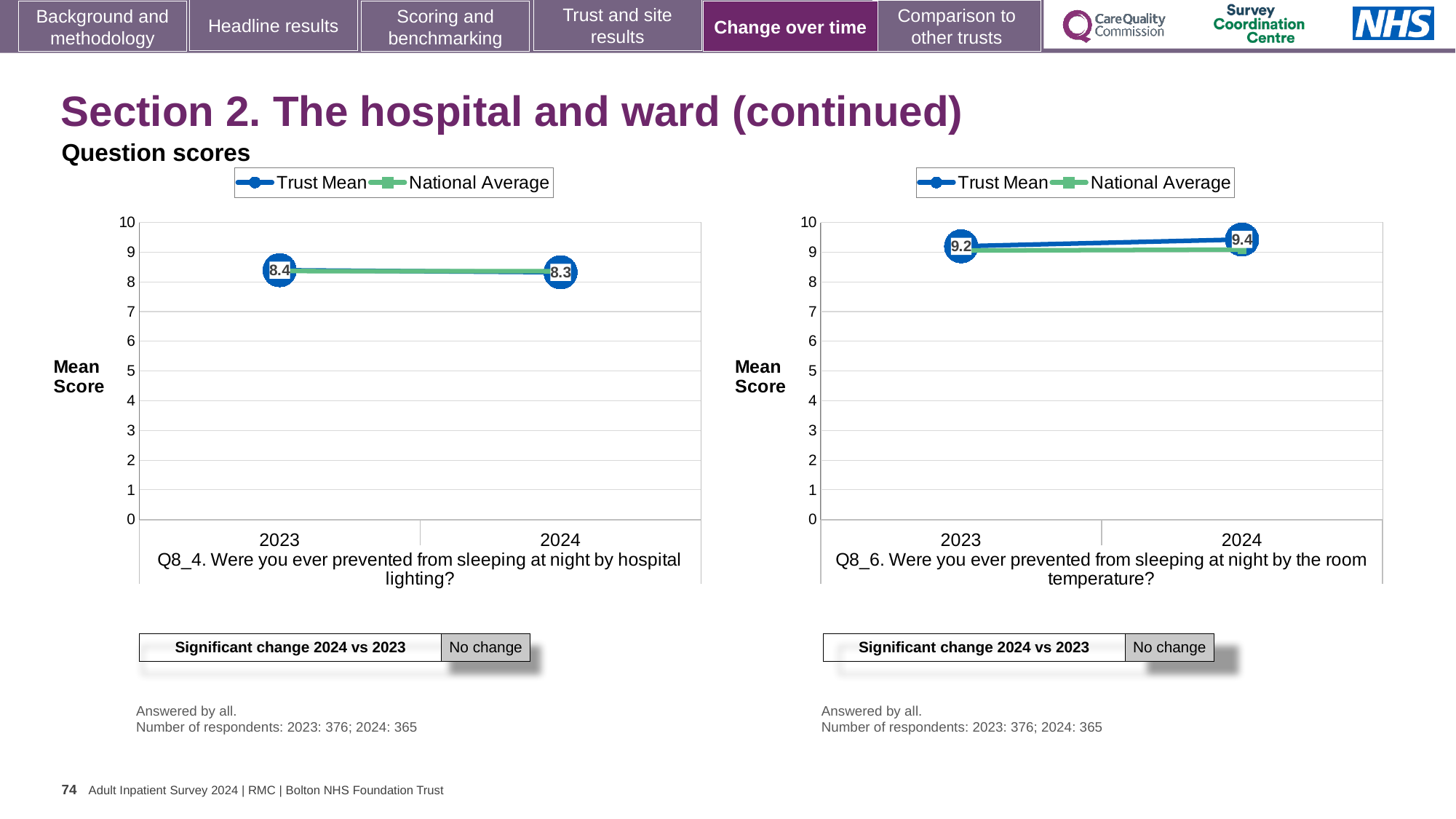
How many series does the legend of the Q8_4 chart (left) list? 2 In the Q8_4 chart (left), does the Trust Mean rise or fall from 2023 to 2024? fall In the Q8_4 chart (left), what is the Trust Mean score for 2023? 8.4 In the Q8_6 chart (right), is the National Average value for 2024 greater or less than 8? greater In the Q8_6 chart (right), does the Trust Mean rise or fall from 2023 to 2024? rise In the Q8_4 chart (left), what is the Trust Mean score for 2024? 8.3 In the Q8_6 chart (right), what is the Trust Mean score for 2023? 9.2 In the Q8_6 chart (right), by how much did the Trust Mean change from 2023 to 2024? 0.2 How many years are plotted on the x axis of the Q8_6 chart (right)? 2 What kind of chart is the Q8_4 chart (left)? line chart What does the 'Significant change 2024 vs 2023' box below the Q8_6 chart (right) say? No change In the Q8_6 chart (right), what is the Trust Mean score for 2024? 9.4